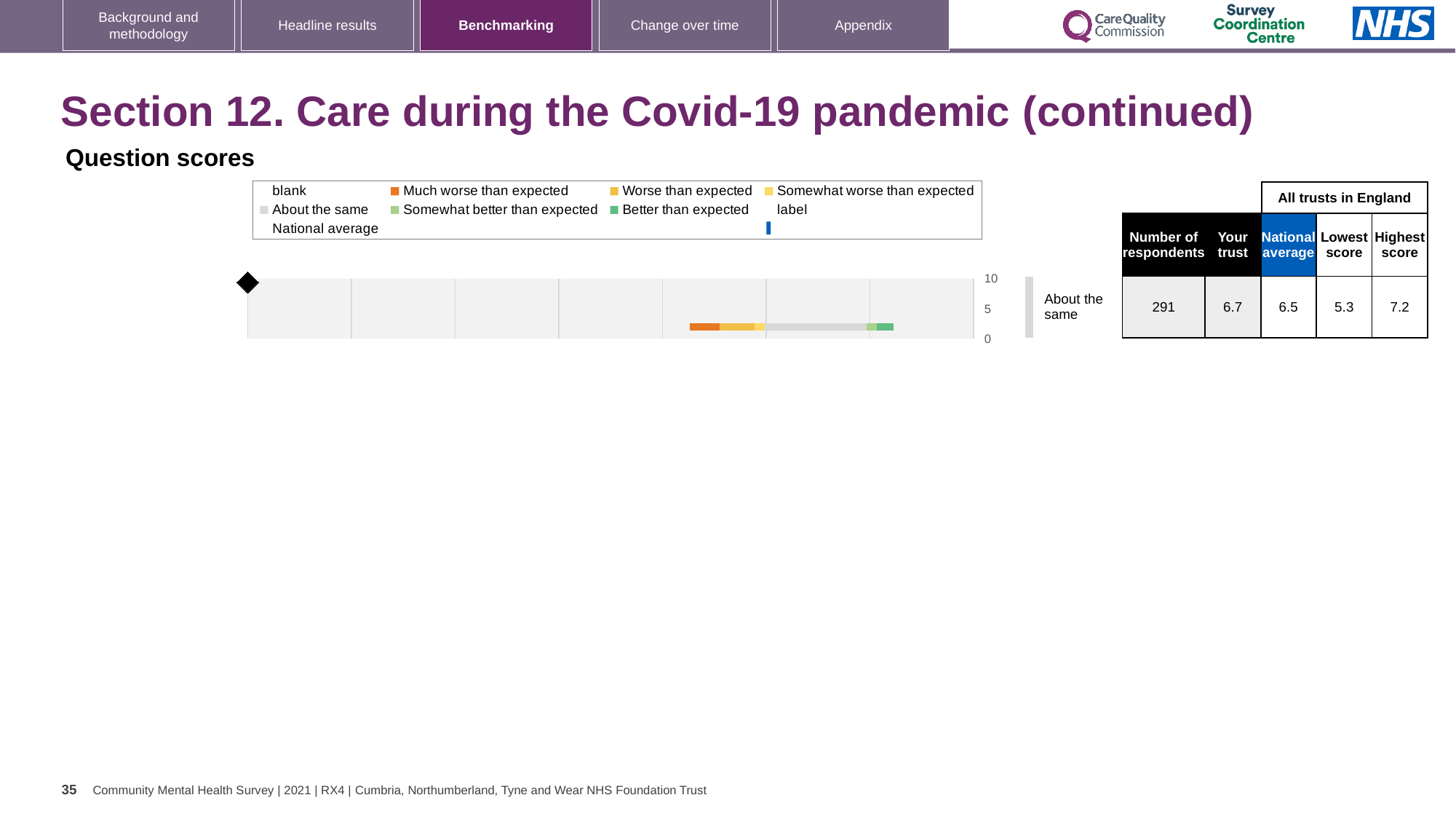
What is the maximum value shown on the chart's score axis? 10 What is the lowest score among all trusts in England for this question? 5.3 What is the national average score shown for this question? 6.5 What is the 'Your trust' score shown for the question on this slide? 6.7 Which legend entry is shown in orange? Much worse than expected What is the difference between the 'Your trust' score and the national average? 0.2 How many respondents are shown for this question? 291 What benchmark category label is shown next to the chart for this question? About the same What is the highest score among all trusts in England for this question? 7.2 What is the difference between the highest score and the lowest score among all trusts in England? 1.9 What kind of chart is shown on the slide? Bar chart Which is larger, the 'Your trust' score or the national average? Your trust